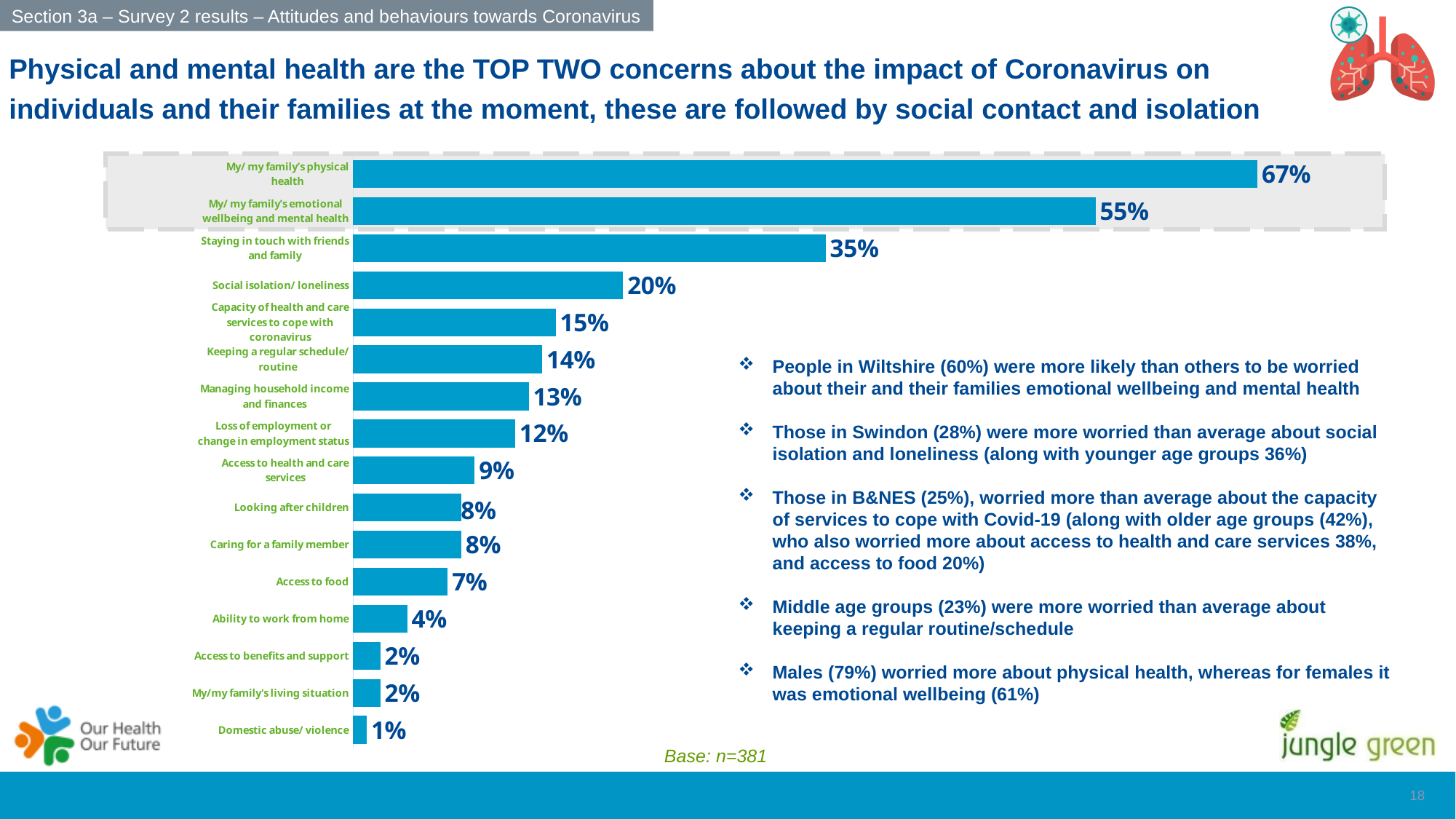
What percentage of respondents were concerned about 'My/ my family's physical health'? 67% What is the value for 'Ability to work from home'? 4% How many categories are shown in the chart? 16 What is the base sample size stated below the chart? n=381 What type of chart is shown on the slide? Bar chart Which category has the lowest value in the chart? Domestic abuse/ violence Which category has the highest value in the chart? My/ my family's physical health What is the value shown for 'Staying in touch with friends and family'? 35% What is the difference between the values for 'My/ my family's physical health' and 'My/ my family's emotional wellbeing and mental health'? 12% Which is larger: the value for 'Managing household income and finances' or 'Loss of employment or change in employment status'? Managing household income and finances What is the difference between the values for 'Access to health and care services' and 'Access to food'? 2% What percentage is shown for 'Social isolation/ loneliness'? 20%